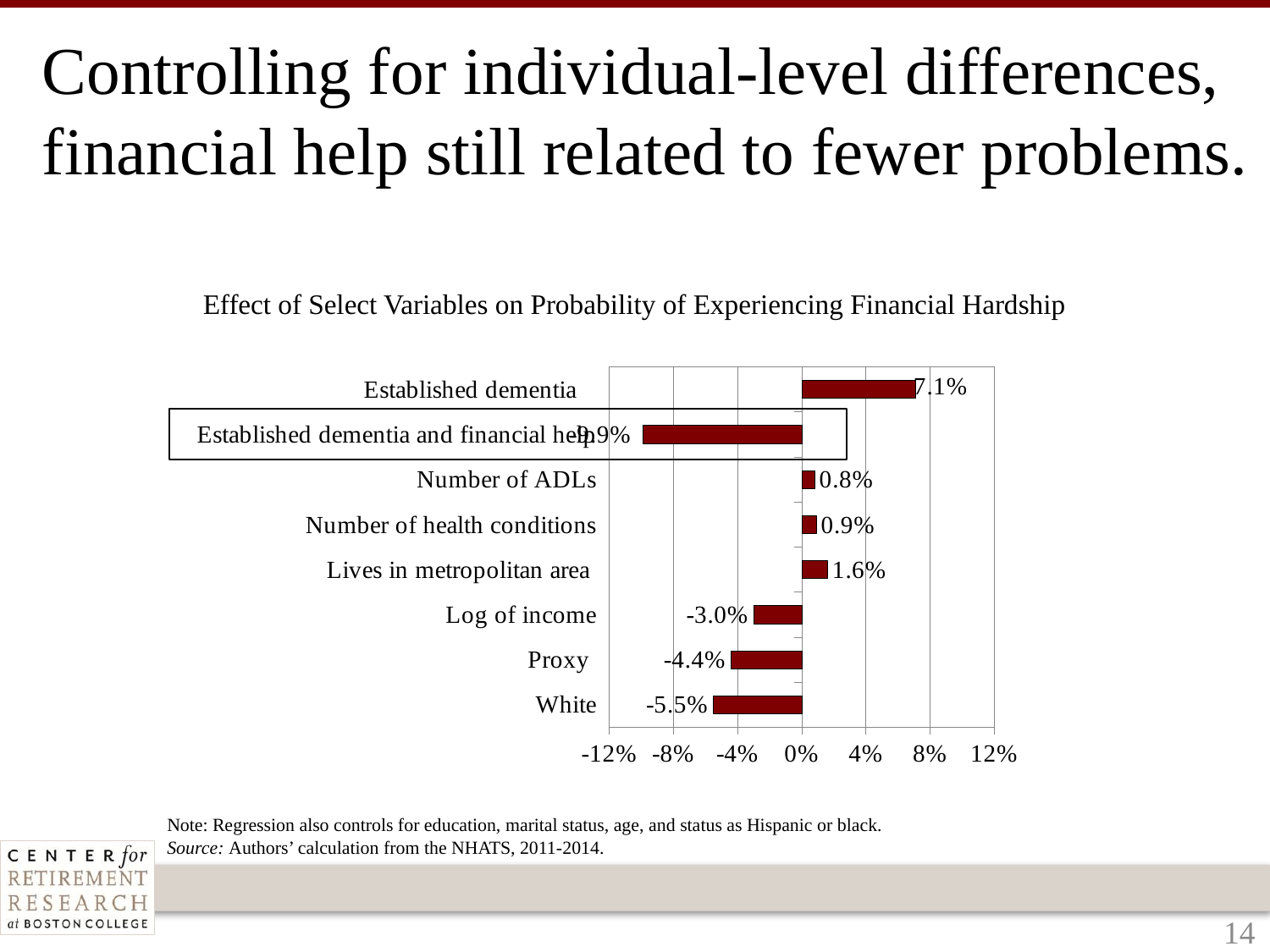
Which has a larger value, Number of ADLs or Number of health conditions? Number of health conditions What is the value for Proxy? -4.4% What is the value for Log of income? -3.0% What is the value for Established dementia? 7.1% What is the value for Lives in metropolitan area? 1.6% What is the difference between the values for Established dementia and Lives in metropolitan area? 5.5 percentage points Which category has the lowest value? Established dementia and financial help How many categories are shown in the chart? 8 Which category has the highest value? Established dementia What is the value for White? -5.5% What type of chart is shown? Bar chart Is the value for Established dementia and financial help greater or less than -8%? less